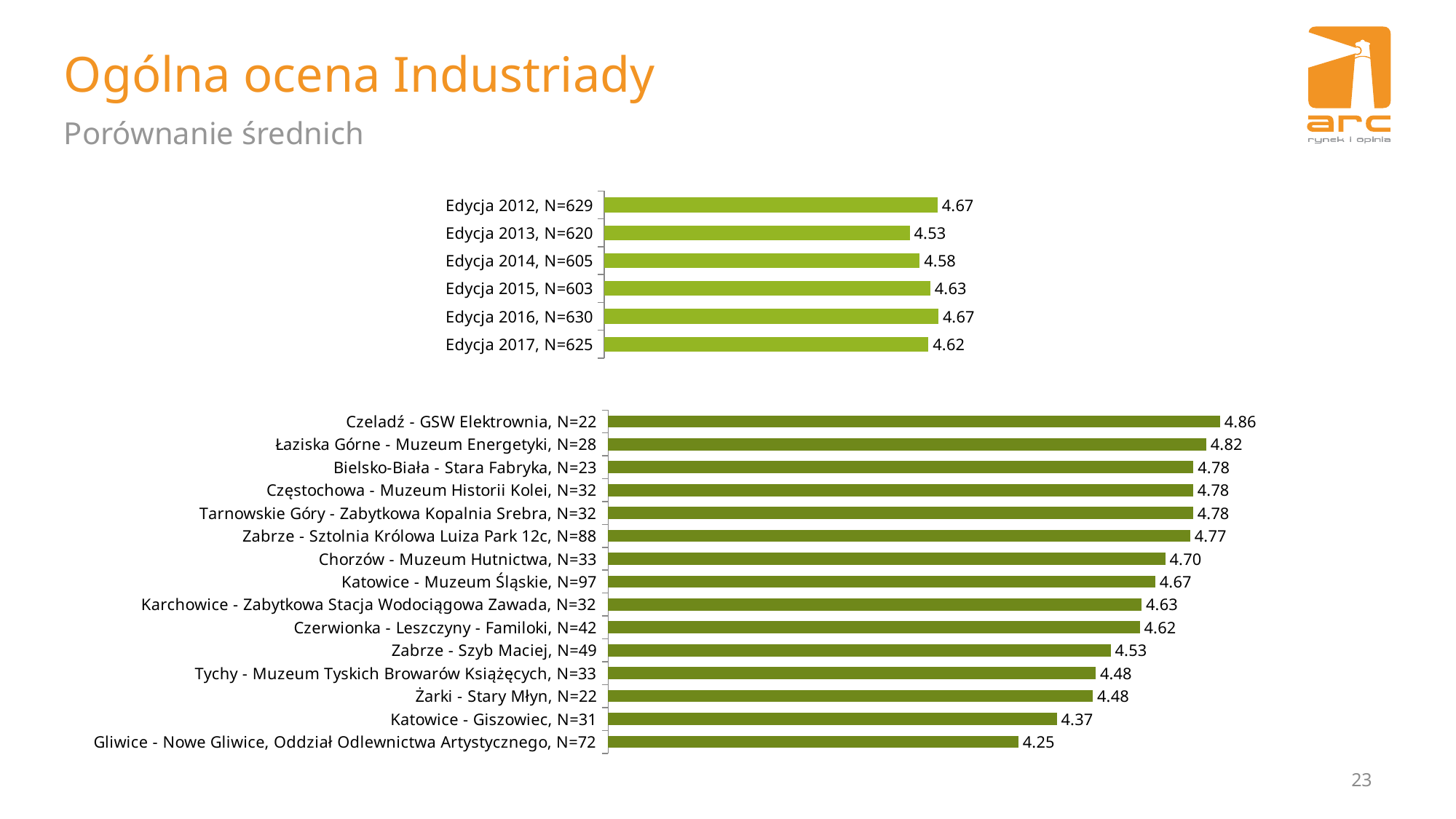
In the top chart, what is the difference between the values for Edycja 2012, N=629 and Edycja 2013, N=620? 0.14 In the bottom chart, which has a larger value: Zabrze - Szyb Maciej, N=49 or Katowice - Muzeum Śląskie, N=97? Katowice - Muzeum Śląskie, N=97 In the top chart, what is the value for Edycja 2013, N=620? 4.53 In the bottom chart, how many locations are shown? 15 In the bottom chart, which location has the lowest value? Gliwice - Nowe Gliwice, Oddział Odlewnictwa Artystycznego, N=72 In the top chart, how many editions are shown? 6 In the bottom chart, which location has the highest value? Czeladź - GSW Elektrownia, N=22 In the bottom chart, what is the value for Chorzów - Muzeum Hutnictwa, N=33? 4.70 In the bottom chart, what is the difference between the values for Czeladź - GSW Elektrownia, N=22 and Katowice - Giszowiec, N=31? 0.49 In the top chart, which edition has the lowest value? Edycja 2013, N=620 What kind of chart is the top chart? Bar chart In the top chart, what is the value for Edycja 2017, N=625? 4.62